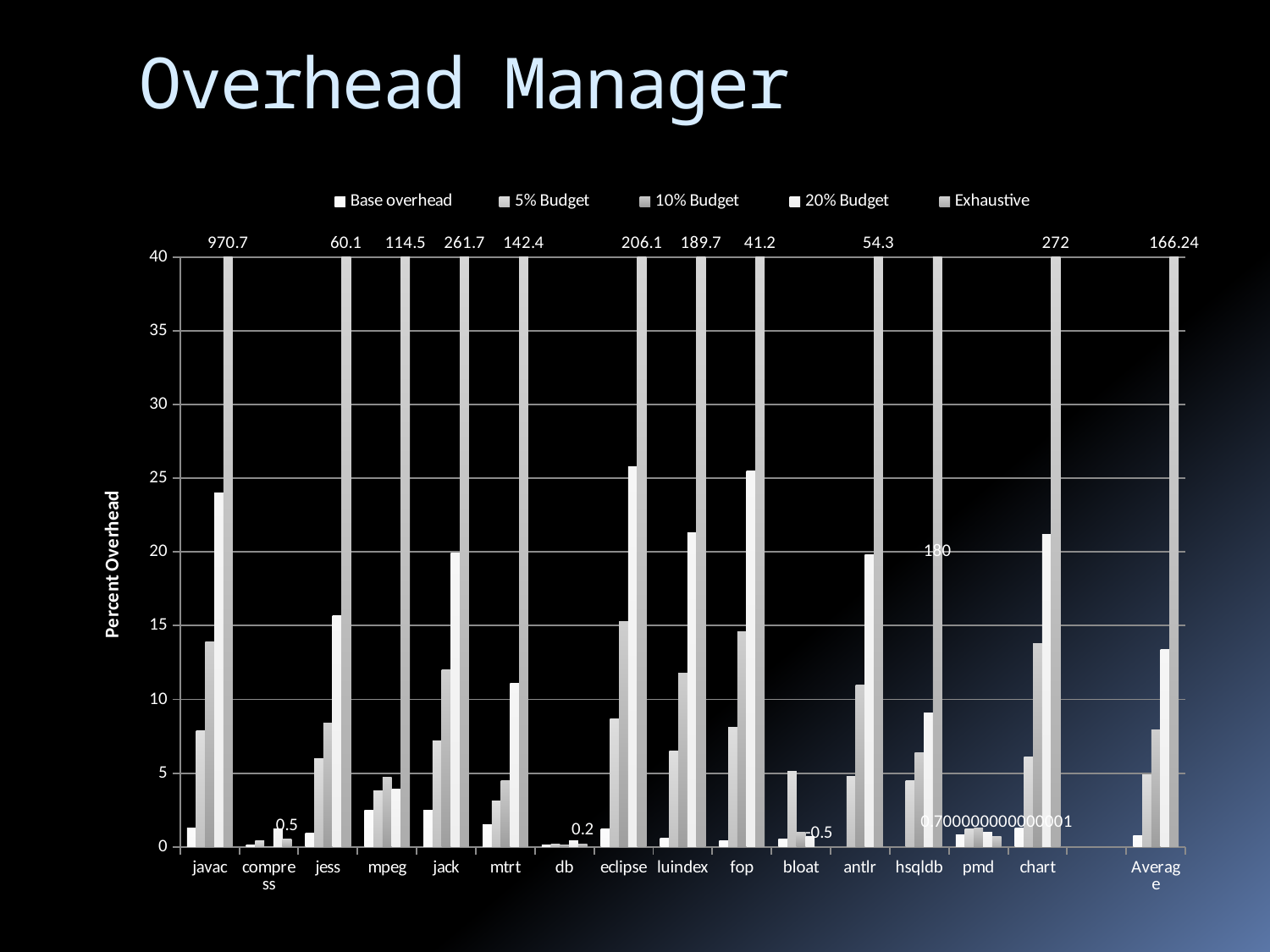
What kind of chart is shown on the slide? bar chart What is the Exhaustive value for javac? 970.7 What is the title of the y axis? Percent Overhead What is the Exhaustive value for Average? 166.24 Which category has the highest Exhaustive value? javac What is the Exhaustive value for jack? 261.7 Is the 20% Budget value for javac greater or less than 20? greater How many categories are shown along the x axis? 16 What is the difference between the Exhaustive values for chart and jess? 211.9 How many series does the legend list? 5 Which has the larger Exhaustive value, jack or mtrt? jack What is the Exhaustive value for fop? 41.2